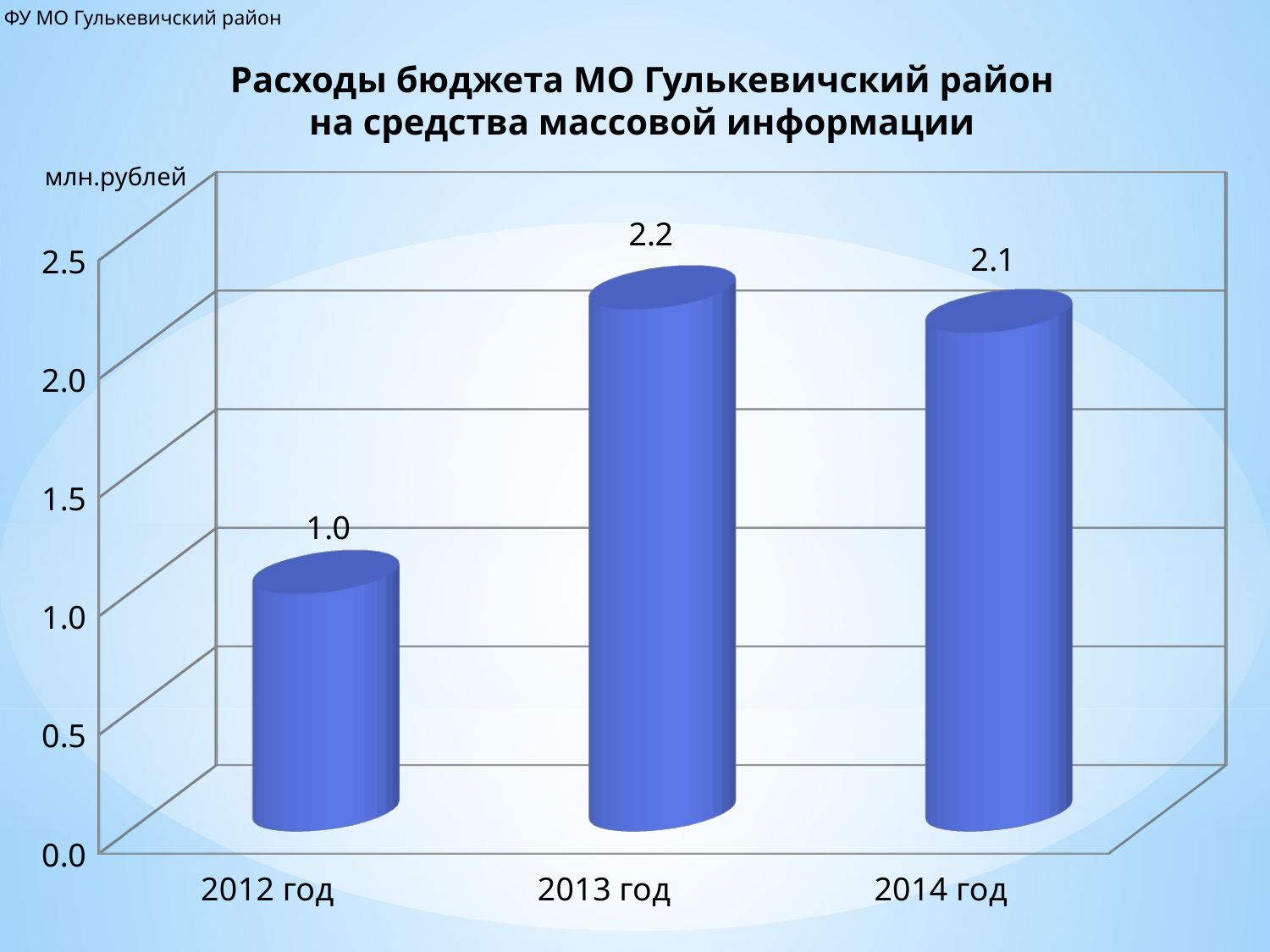
Which is larger, the value for 2012 год or the value for 2014 год? 2014 год What is the value for 2013 год? 2.2 What is the value for 2012 год? 1.0 What is the difference between the values for 2013 год and 2012 год? 1.2 How many years are shown on the chart? 3 What kind of chart is shown on the slide? bar chart What is the value for 2014 год? 2.1 What is the difference between the values for 2013 год and 2014 год? 0.1 Which year has the lowest value? 2012 год What unit is shown on the vertical axis of the chart? млн.рублей Which year has the highest value? 2013 год Is the value for 2014 год greater or less than 1.5? greater